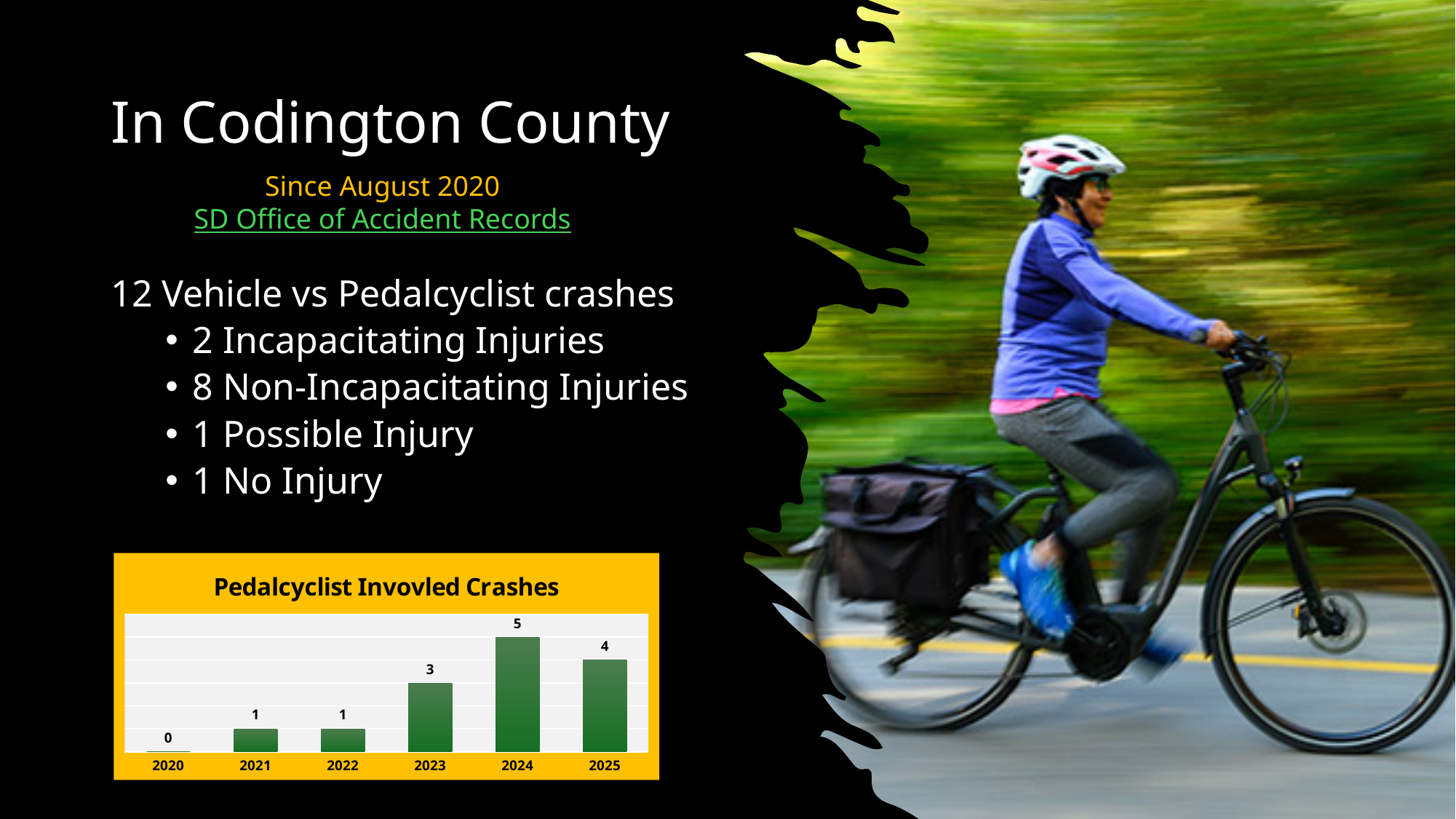
What is the difference between the number of crashes in 2024 and 2025? 1 What type of chart is shown on the slide? bar chart How many pedalcyclist involved crashes are shown for 2024? 5 What is the total number of crashes shown across all years in the chart? 14 What is the title of the chart on the slide? Pedalcyclist Invovled Crashes What colour are the bars in the chart? green How many pedalcyclist involved crashes are shown for 2020? 0 Which year has the highest number of pedalcyclist involved crashes? 2024 Which year had more pedalcyclist involved crashes, 2023 or 2025? 2025 How many years are shown on the x axis of the chart? 6 How many pedalcyclist involved crashes are shown for 2023? 3 Which year has the lowest number of pedalcyclist involved crashes? 2020